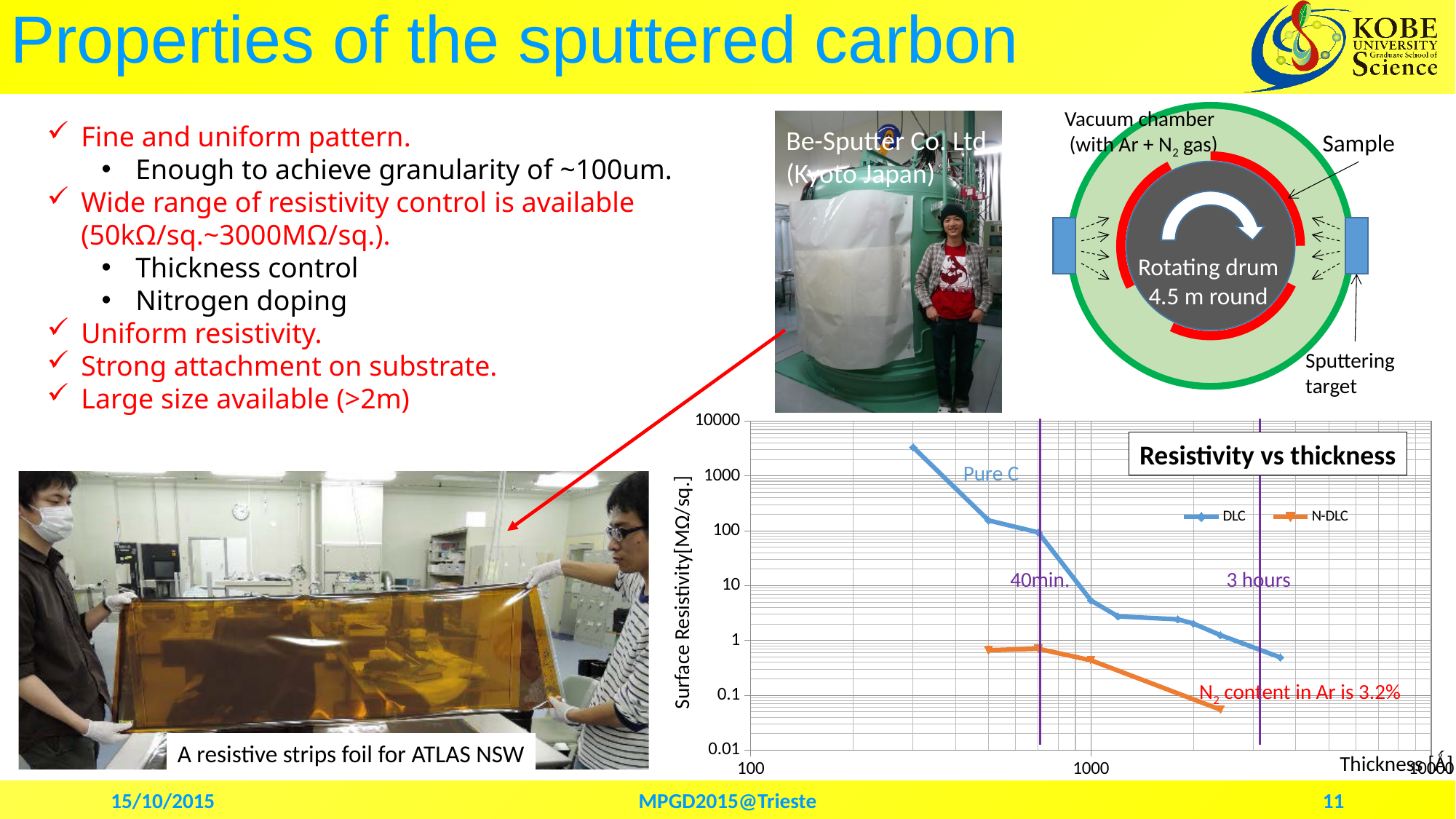
In the 'Resistivity vs thickness' chart, does the DLC surface resistivity rise or fall as thickness increases? fall In the 'Resistivity vs thickness' chart, which series has the higher surface resistivity at a thickness of 1000 Å, DLC or N-DLC? DLC In the 'Resistivity vs thickness' chart, are all N-DLC values greater or less than 1 MΩ/sq.? less In the 'Resistivity vs thickness' chart, is the DLC value at a thickness of 1000 Å greater or less than 10 MΩ/sq.? less In the 'Resistivity vs thickness' chart, is the last N-DLC point (at the largest thickness) greater or less than 0.1 MΩ/sq.? less What kind of chart is the 'Resistivity vs thickness' chart? line chart Which two series are listed in the legend of the 'Resistivity vs thickness' chart? DLC and N-DLC In the 'Resistivity vs thickness' chart, which series reaches the highest surface resistivity, DLC or N-DLC? DLC How many series does the legend of the 'Resistivity vs thickness' chart list? 2 In the 'Resistivity vs thickness' chart, does the N-DLC surface resistivity rise or fall overall as thickness increases? fall What is the y-axis label of the 'Resistivity vs thickness' chart? Surface Resistivity[MΩ/sq.]